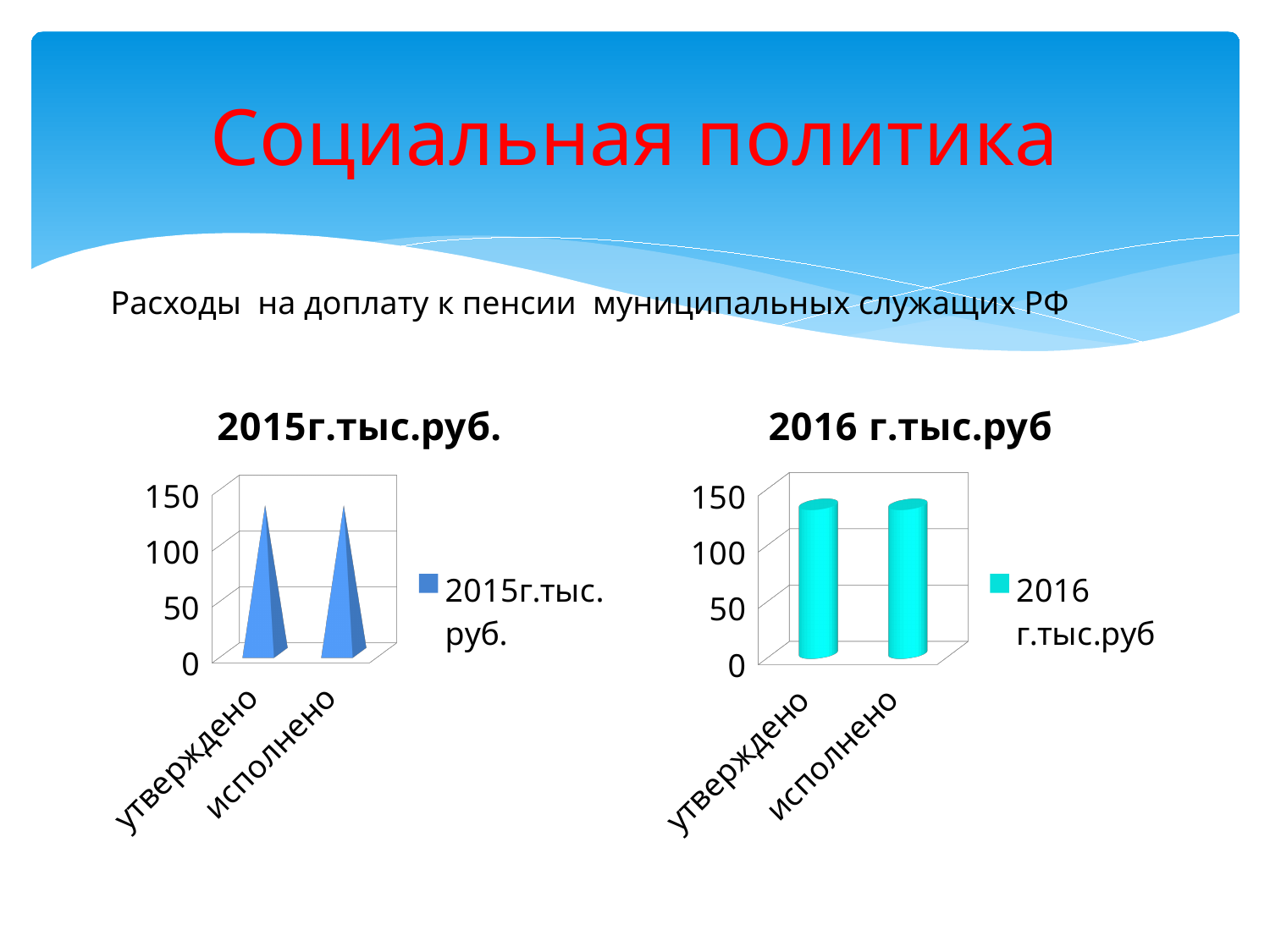
In the chart titled "2015г.тыс.руб.", is the value for исполнено greater or less than 150? less In the chart titled "2016 г.тыс.руб", is the value for утверждено greater or less than 100? greater What legend entry is shown in the chart titled "2016 г.тыс.руб"? 2016 г.тыс.руб What is the title of the chart on the left side of the slide? 2015г.тыс.руб. In the chart titled "2016 г.тыс.руб", how many categories are shown on the x axis? 2 What kind of chart is the chart titled "2015г.тыс.руб."? bar chart In the chart titled "2016 г.тыс.руб", how many series does the legend list? 1 In the chart titled "2016 г.тыс.руб", is the value for исполнено greater or less than 150? less In the chart titled "2015г.тыс.руб.", how many categories are shown on the x axis? 2 What kind of chart is the chart titled "2016 г.тыс.руб"? bar chart In the chart titled "2015г.тыс.руб.", how many series does the legend list? 1